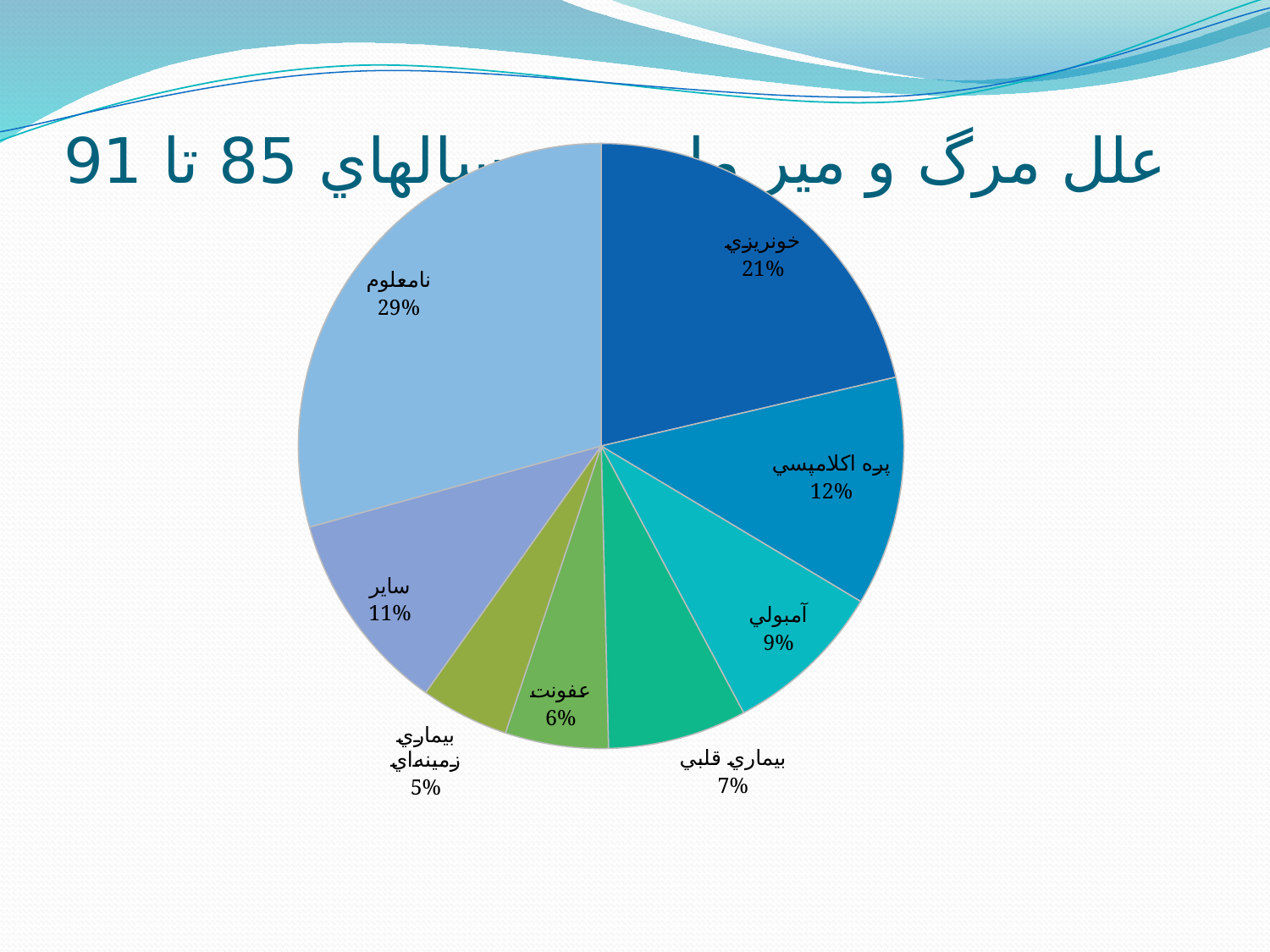
What percentage is shown for the slice labelled نامعلوم? 29% What percentage is shown for the slice labelled بيماري قلبي? 7% What percentage is shown for the slice labelled خونريزي? 21% What share of the pie does the ساير slice represent? 11% How many slices does the pie chart have? 8 Which slice has the smallest share of the pie? بيماري زمينه‌اي What kind of chart is shown on the slide? pie chart What percentage is shown for the slice labelled آمبولي? 9% Which slice has the largest share of the pie? نامعلوم What is the difference in percentage points between the نامعلوم slice and the خونريزي slice? 8 What percentage is shown for the slice labelled پره اكلامپسي? 12% Which slice is larger, ساير or عفونت? ساير